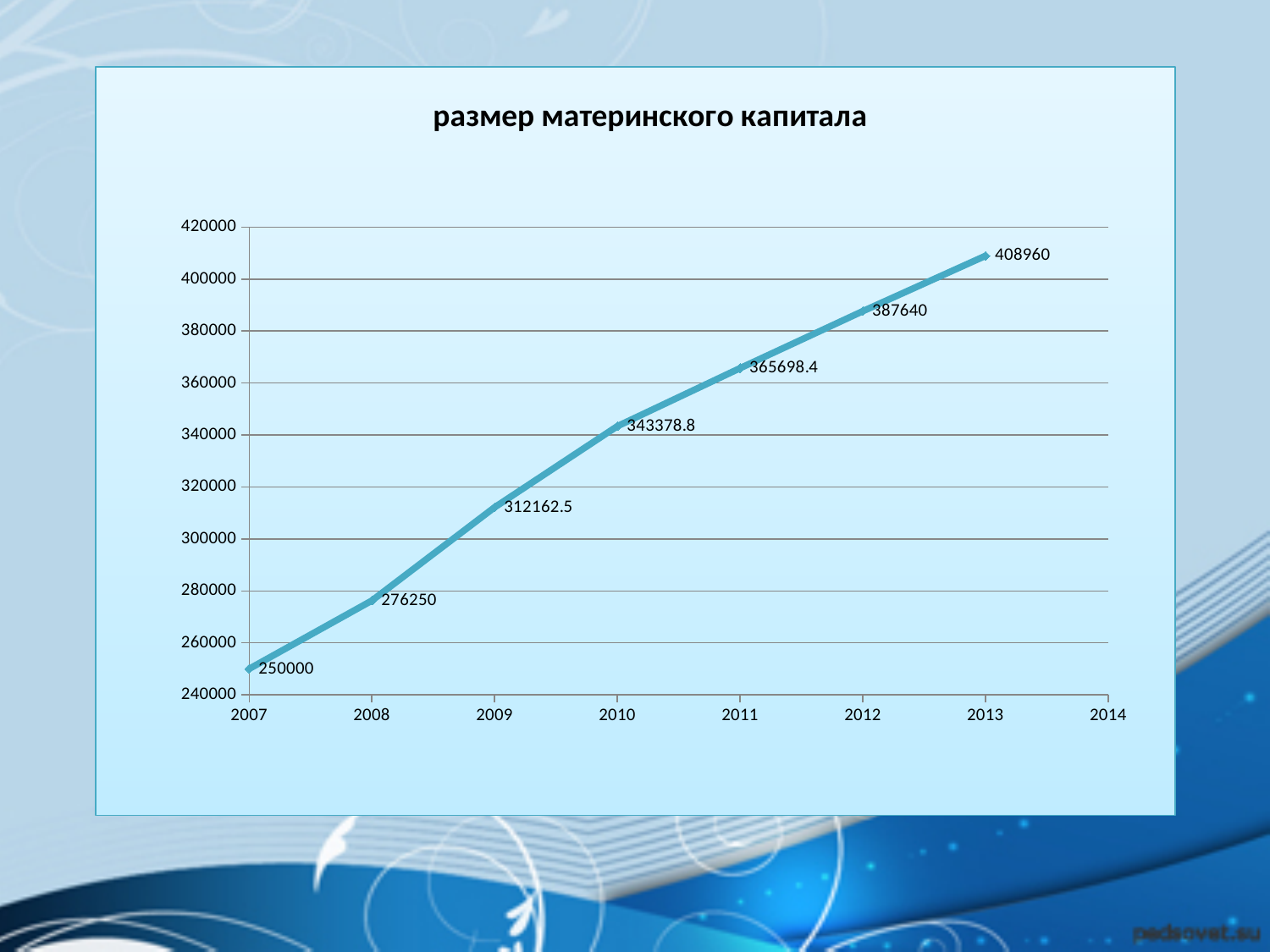
Which year has the lowest value? 2007 Which is larger, the value for 2010 or the value for 2012? 2012 What is the value for 2013? 408960 What is the difference between the values for 2008 and 2007? 26250 What kind of chart is shown? line chart What is the value for 2007? 250000 Do the values rise or fall from 2007 to 2013? rise What is the difference between the values for 2013 and 2007? 158960 What is the value for 2011? 365698.4 How many data points are plotted on the line? 7 What is the value for 2009? 312162.5 Which year has the highest value? 2013